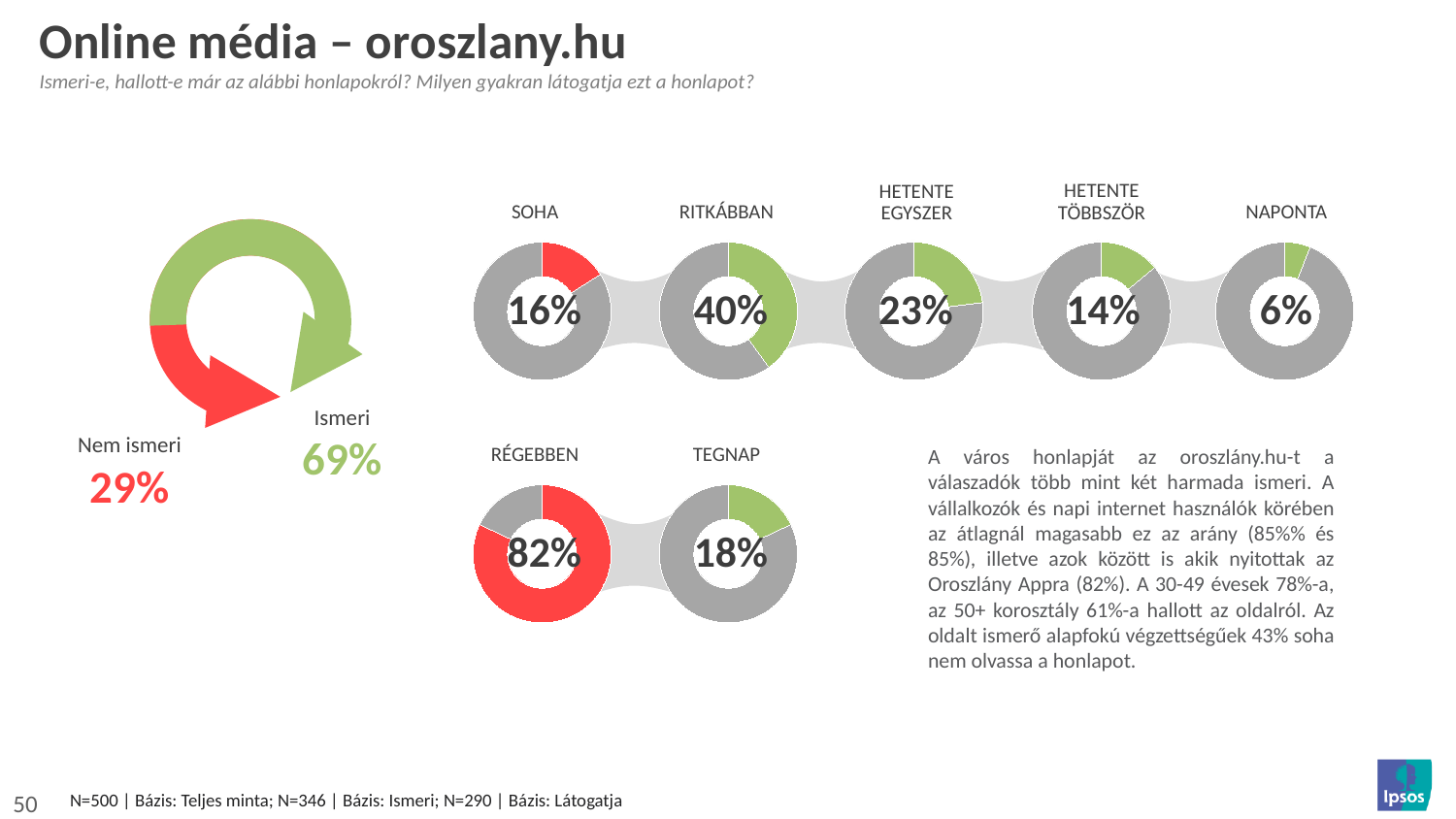
In the large donut chart on the left, what percentage is shown for "Ismeri"? 69% In the row of five small donut charts at the top, which category has the highest percentage? RITKÁBBAN In the large donut chart on the left, what percentage is shown for "Nem ismeri"? 29% In the row of five small donut charts at the top, what percentage is shown for "HETENTE EGYSZER"? 23% In the large donut chart on the left, which is larger, "Ismeri" or "Nem ismeri"? Ismeri In the row of five small donut charts at the top, what is the difference between the "RITKÁBBAN" and "HETENTE TÖBBSZÖR" percentages? 26% In the row of five small donut charts at the top, what percentage is shown for "NAPONTA"? 6% In the row of five small donut charts at the top, which category has the lowest percentage? NAPONTA In the row of five small donut charts at the top, what percentage is shown for "SOHA"? 16% In the pair of donut charts at the bottom, what percentage is shown for "RÉGEBBEN"? 82% In the row of five small donut charts at the top, what percentage is shown for "RITKÁBBAN"? 40% How many small donut charts are in the top row of frequency charts? 5